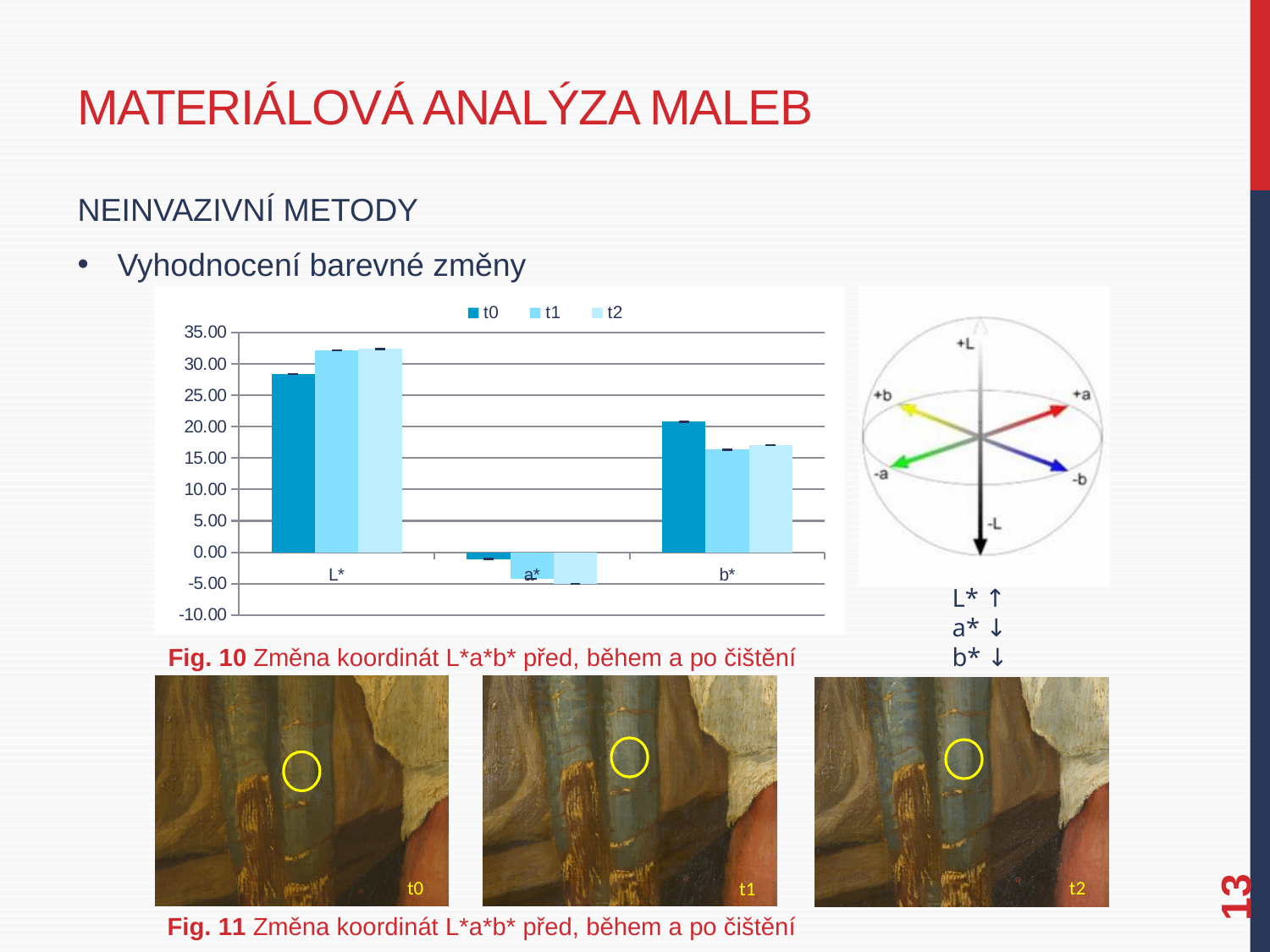
How many series does the legend of the chart list? 3 Is the value of t0 for L* greater or less than 25.00? greater What kind of chart is shown in Fig. 10? bar chart Is the value of t1 for b* greater or less than 20.00? less Which category has the highest bars in the chart? L* For b*, which series has the highest bar? t0 Is the value of t2 for a* greater or less than 0.00? less For L*, which is larger: t0 or t1? t1 Which category has the lowest bars in the chart? a* How many categories are shown on the x axis of the chart? 3 What are the series names listed in the chart legend? t0, t1, t2